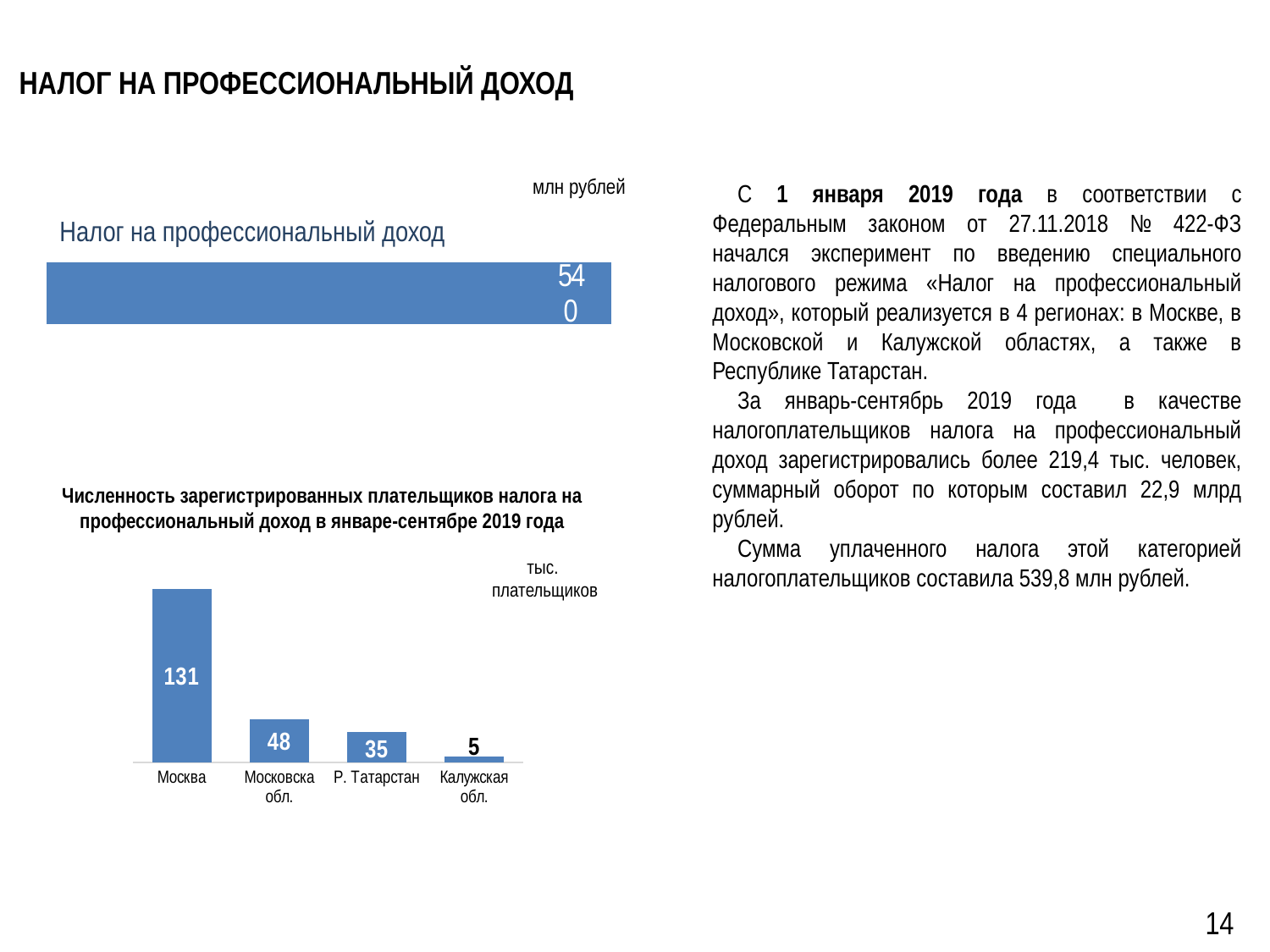
In the bottom chart on the number of registered taxpayers, do the values rise or fall from left to right? fall How many regions are shown in the bottom chart on the number of registered taxpayers? 4 What kind of chart is the bottom chart on the number of registered taxpayers? bar chart In the bottom chart on the number of registered taxpayers, what is the difference between the values for Москва and Московская обл.? 83 In the bottom chart on the number of registered taxpayers, what is the value for Москва? 131 In the bottom chart on the number of registered taxpayers, what is the value for Калужская обл.? 5 In the bottom chart on the number of registered taxpayers, which region has the lowest value? Калужская обл. In the bottom chart on the number of registered taxpayers, which region has the highest value? Москва In the bottom chart on the number of registered taxpayers, what is the value for Московская обл.? 48 In the bottom chart on the number of registered taxpayers, which is larger: the value for Московская обл. or the value for Р. Татарстан? Московская обл. In the bottom chart on the number of registered taxpayers, what is the value for Р. Татарстан? 35 What unit is shown for the bottom chart on the number of registered taxpayers? тыс. плательщиков